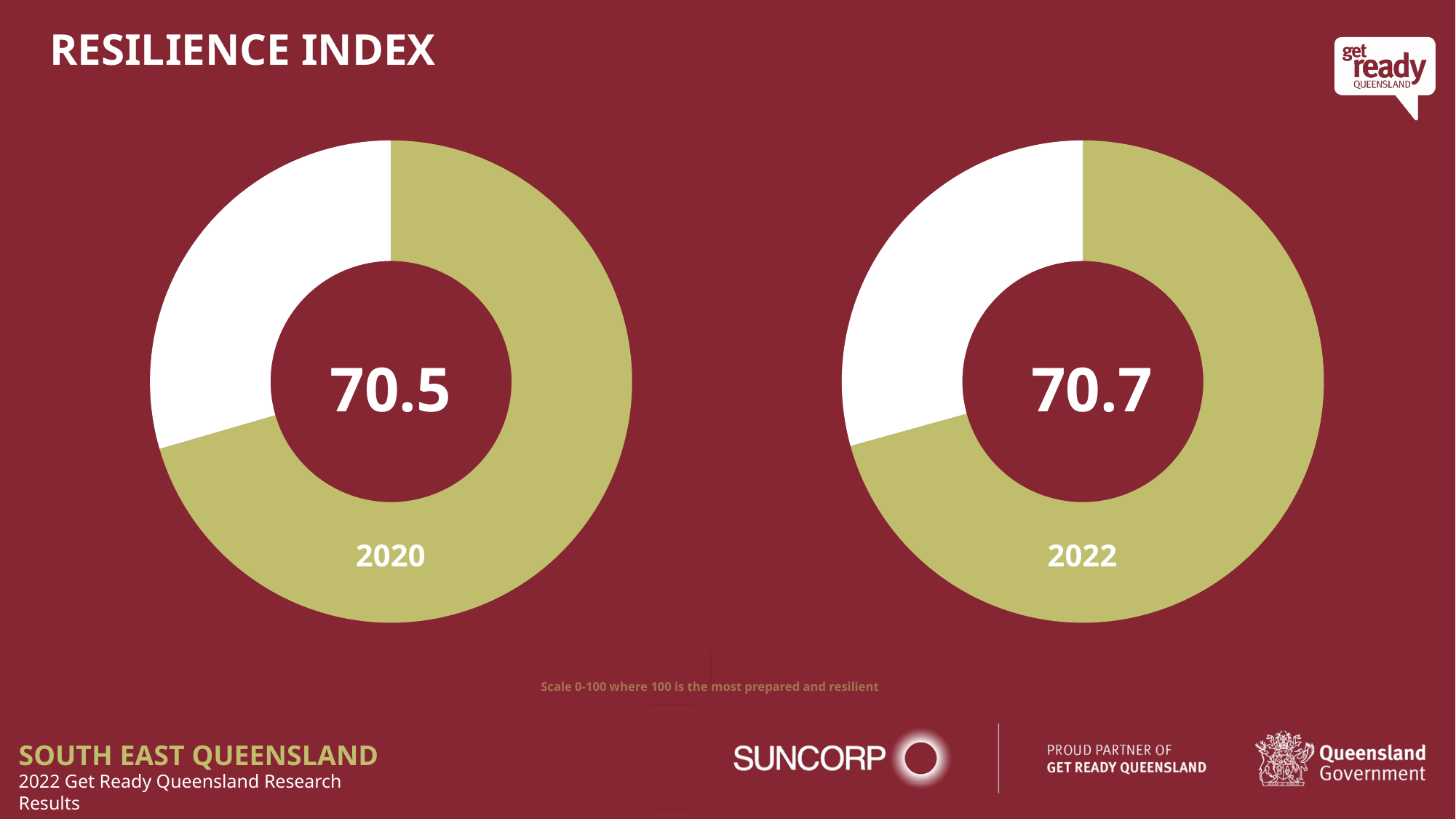
Which year has the lower Resilience Index value? 2020 What is the title of the slide? RESILIENCE INDEX Which year has the higher Resilience Index value, 2020 or 2022? 2022 How many charts are shown on the slide? 2 What is the Resilience Index value shown in the 2020 chart? 70.5 According to the note on the slide, what scale is the Resilience Index measured on? 0-100 where 100 is the most prepared and resilient What is the Resilience Index value shown in the 2022 chart? 70.7 What is the difference between the 2022 and 2020 Resilience Index values? 0.2 In the 2020 chart, is the Resilience Index value greater or less than 50? greater Did the Resilience Index rise or fall from 2020 to 2022? Rise What kind of chart is used to show the Resilience Index for each year? Donut (pie) chart